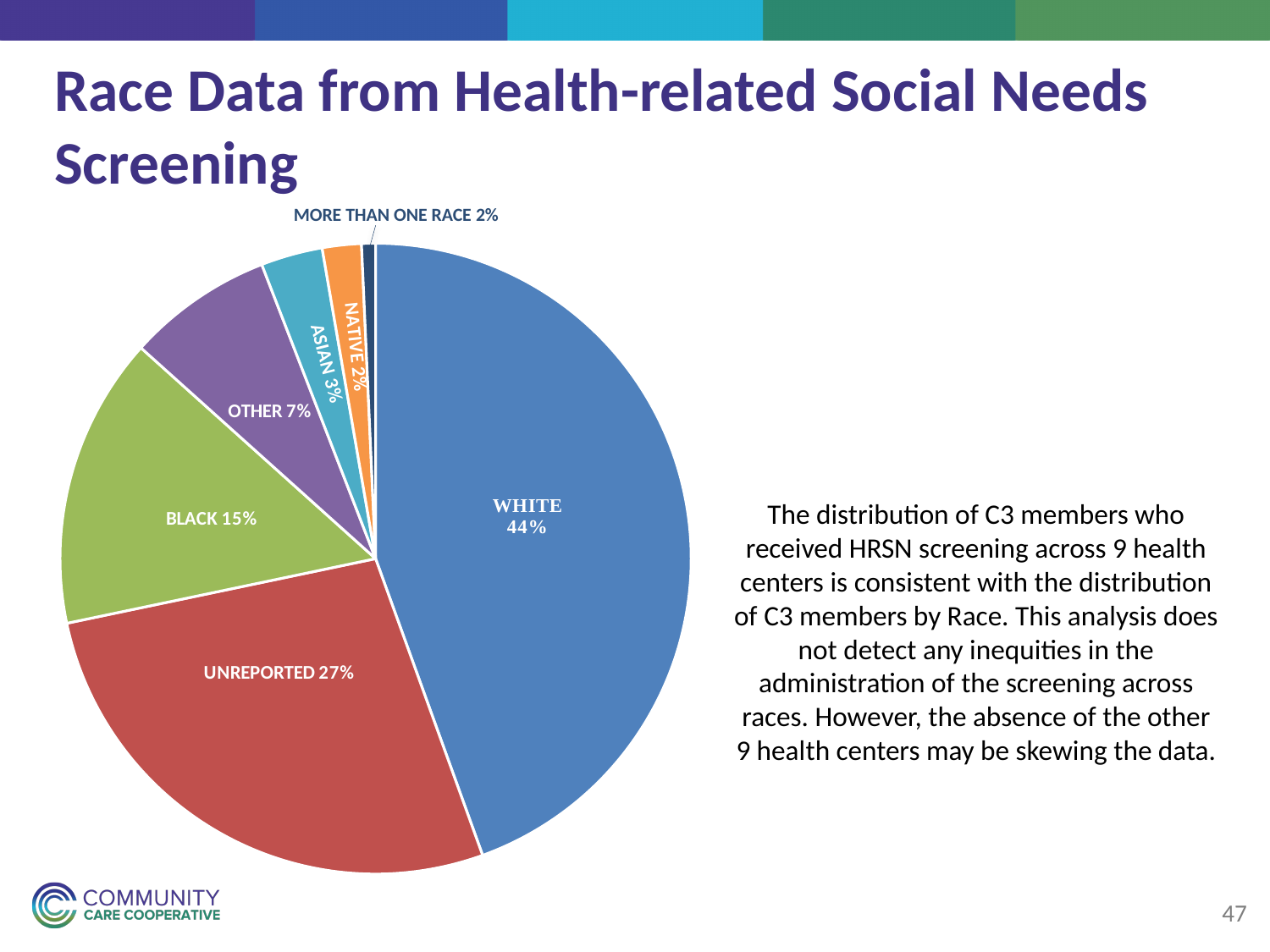
What percentage is shown for BLACK? 15% What percentage is shown for OTHER? 7% What is the difference in percentage points between WHITE and UNREPORTED? 17 Which race category has the largest slice of the pie? WHITE How many slices does the pie chart have? 7 What share of the pie is labelled WHITE? 44% What kind of chart is shown on the slide? Pie chart What percentage is shown for MORE THAN ONE RACE? 2% Which is larger, the BLACK slice or the OTHER slice? BLACK What is the combined percentage of BLACK and OTHER? 22% What percentage is shown for ASIAN? 3% What percentage is shown for UNREPORTED? 27%